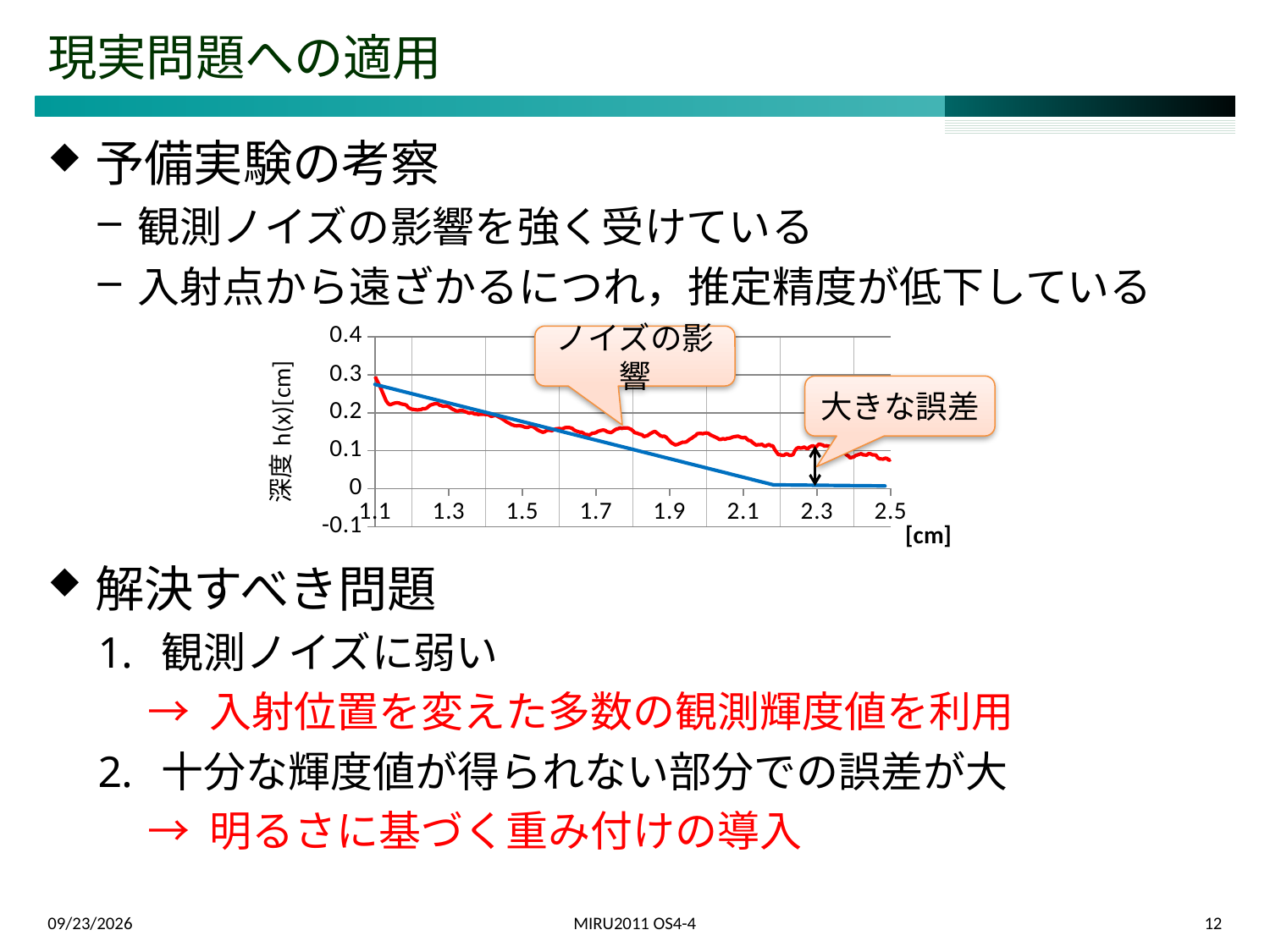
Is the value of the blue line at x = 2.5 greater or less than 0.1? less Does the blue line rise or fall as x increases from 1.1 to 2.2? fall At x = 2.1, which line has the larger value, the red line or the blue line? red line What unit is shown for the horizontal axis of the chart? [cm] What is the label of the vertical axis of the chart? 深度 h(x)[cm] Does the red line rise or fall overall from x = 1.1 to x = 2.5? fall Is the value of the blue line at x = 1.9 greater or less than 0.1? less How many lines are plotted in the chart? 2 Is the value of the red line at x = 1.9 greater or less than 0.1? greater At x = 2.3, which line has the larger value, the red line or the blue line? red line What kind of chart is shown on the slide? line chart